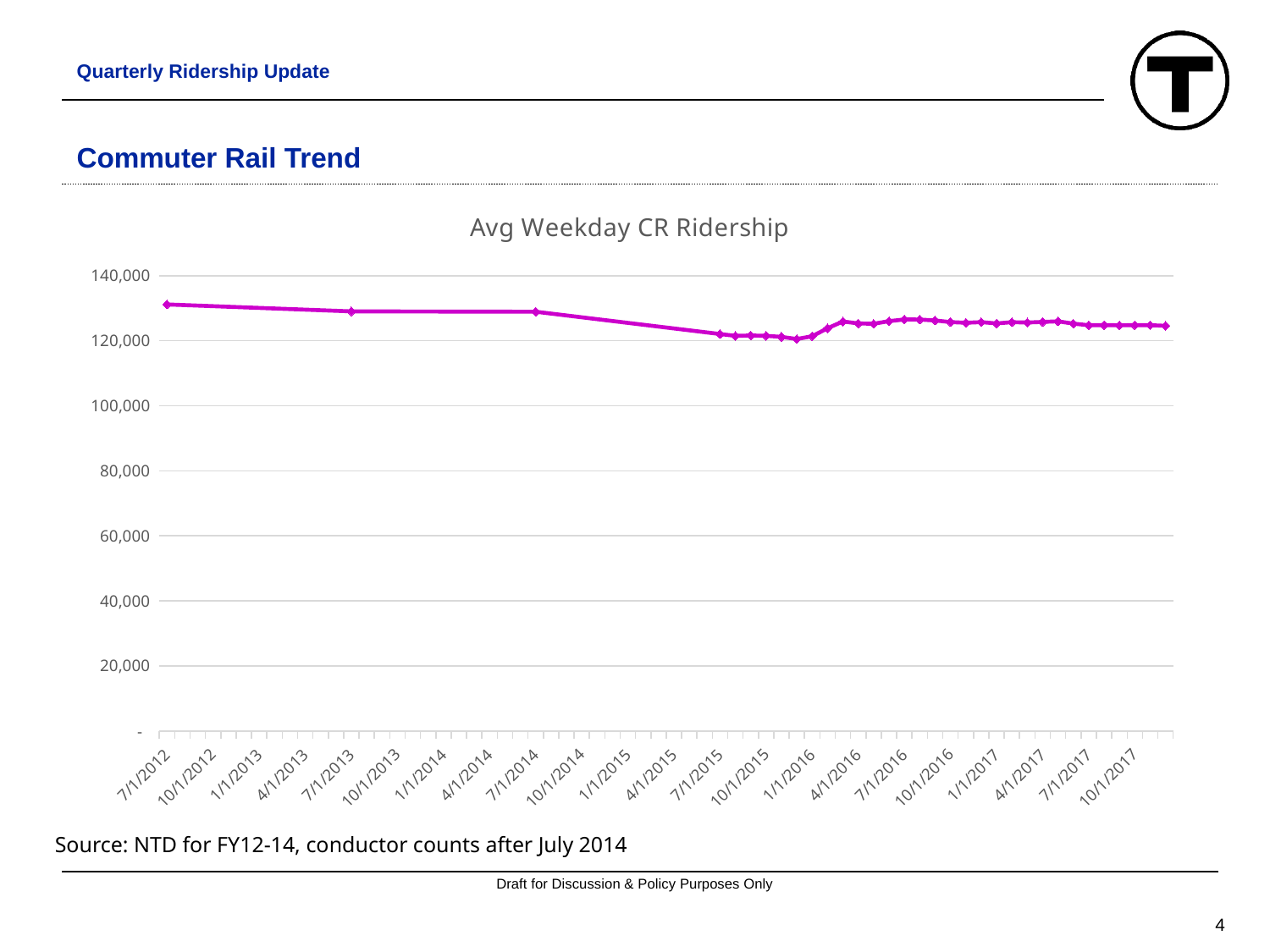
Which is larger, the value for 7/1/2014 or the value for 10/1/2015? 7/1/2014 Do the values rise or fall from 7/1/2012 to 1/1/2016? fall How many date labels are shown on the x axis? 22 Is the value for 10/1/2017 greater or less than 100,000? greater Is the value for 7/1/2012 greater or less than 120,000? greater Is the value for 7/1/2012 greater or less than 140,000? less What is the title of the chart? Avg Weekday CR Ridership Which date on the x axis has the highest ridership value? 7/1/2012 Which is larger, the value for 7/1/2012 or the value for 1/1/2016? 7/1/2012 What kind of chart is shown on the slide? line chart